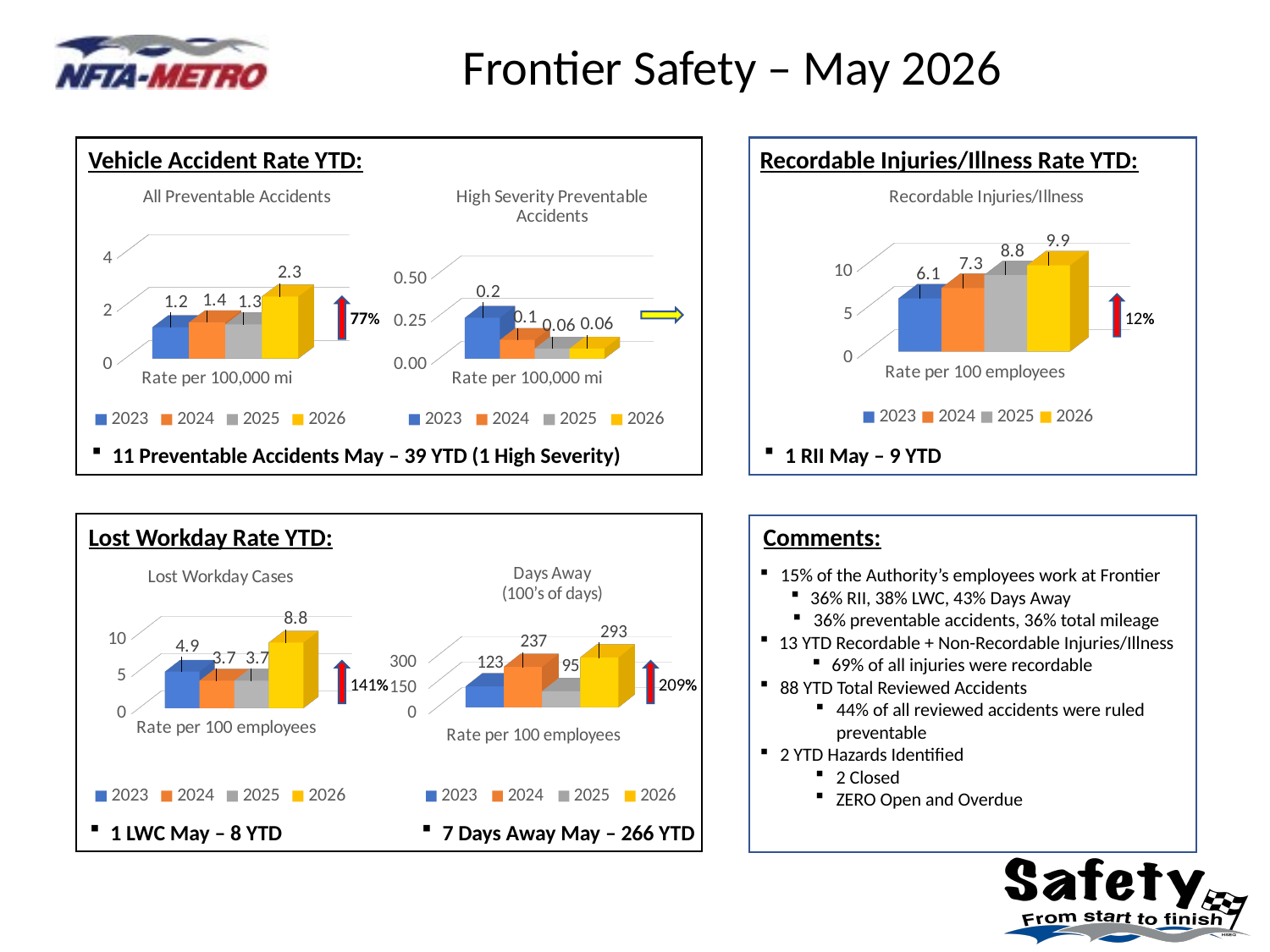
How many series does the legend of the Days Away chart list? 4 In the Days Away chart, which is larger, the value for 2024 or the value for 2026? 2026 In the Recordable Injuries/Illness chart, what is the value for 2025? 8.8 In the Lost Workday Cases chart, what is the value for 2023? 4.9 In the High Severity Preventable Accidents chart, what is the value for 2023? 0.2 In the Lost Workday Cases chart, what is the difference between the 2026 and 2023 values? 3.9 In the Recordable Injuries/Illness chart, which year has the lowest value? 2023 In the Recordable Injuries/Illness chart, do the values rise or fall from 2023 to 2026? rise In the All Preventable Accidents chart, what is the value for 2026? 2.3 In the High Severity Preventable Accidents chart, what is the difference between the 2023 and 2024 values? 0.1 In the Days Away chart, which year has the lowest value? 2025 In the All Preventable Accidents chart, which year has the highest rate? 2026